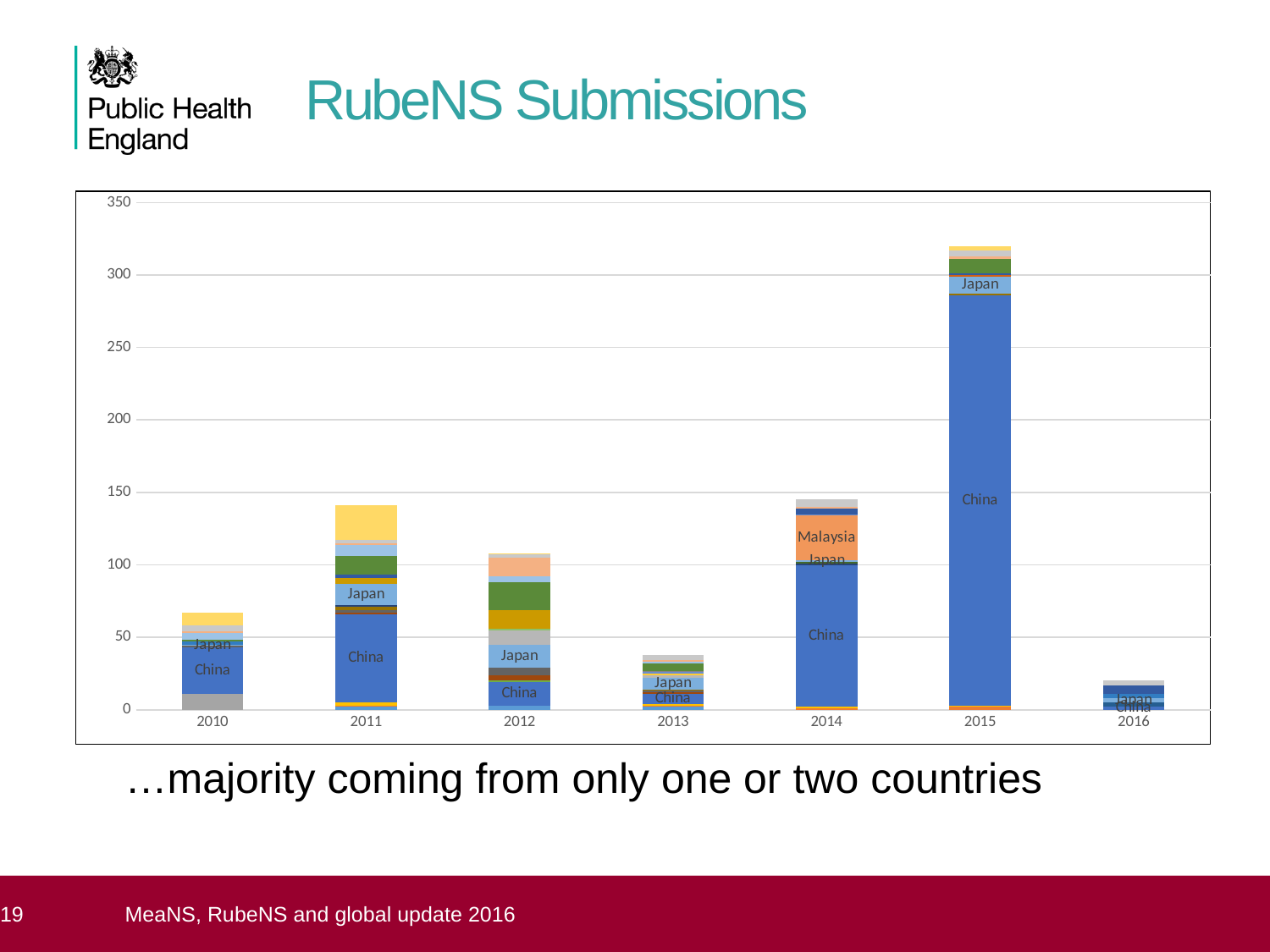
Is the total for 2010 greater or less than 50? greater Which year has the shortest bar in the chart? 2016 Is the total for 2015 greater or less than 300? greater Is the total for 2016 greater or less than 50? less Which year has the taller bar, 2011 or 2012? 2011 How many years are shown along the x axis of the chart? 7 What kind of chart is shown on the slide? stacked bar chart Which year has the tallest bar in the chart? 2015 Which country is labelled on the largest segment of the 2015 bar? China What is the title of the slide containing the chart? RubeNS Submissions